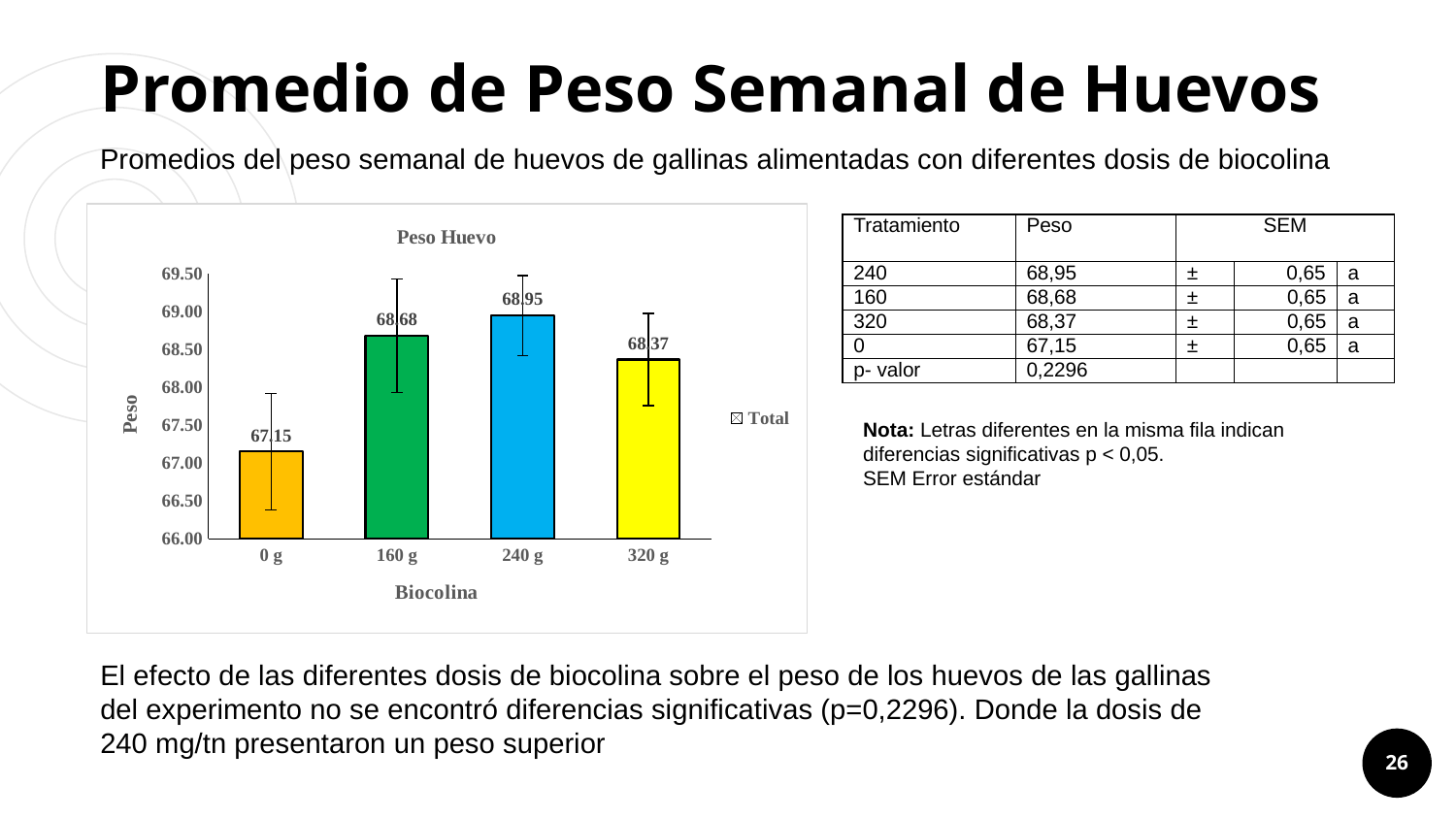
What is the difference between the values for 240 g and 0 g in the Peso Huevo chart? 1.80 Is the value for 0 g in the Peso Huevo chart greater or less than 67.50? less How many categories are shown on the x axis of the Peso Huevo chart? 4 What is the value for 0 g in the Peso Huevo chart? 67.15 What kind of chart is the Peso Huevo chart? bar chart Which category has the lowest value in the Peso Huevo chart? 0 g What is the value for 240 g in the Peso Huevo chart? 68.95 What is the value for 320 g in the Peso Huevo chart? 68.37 Which is larger in the Peso Huevo chart, the value for 160 g or the value for 320 g? 160 g What is the x-axis title of the Peso Huevo chart? Biocolina Which category has the highest value in the Peso Huevo chart? 240 g What is the difference between the values for 160 g and 320 g in the Peso Huevo chart? 0.31